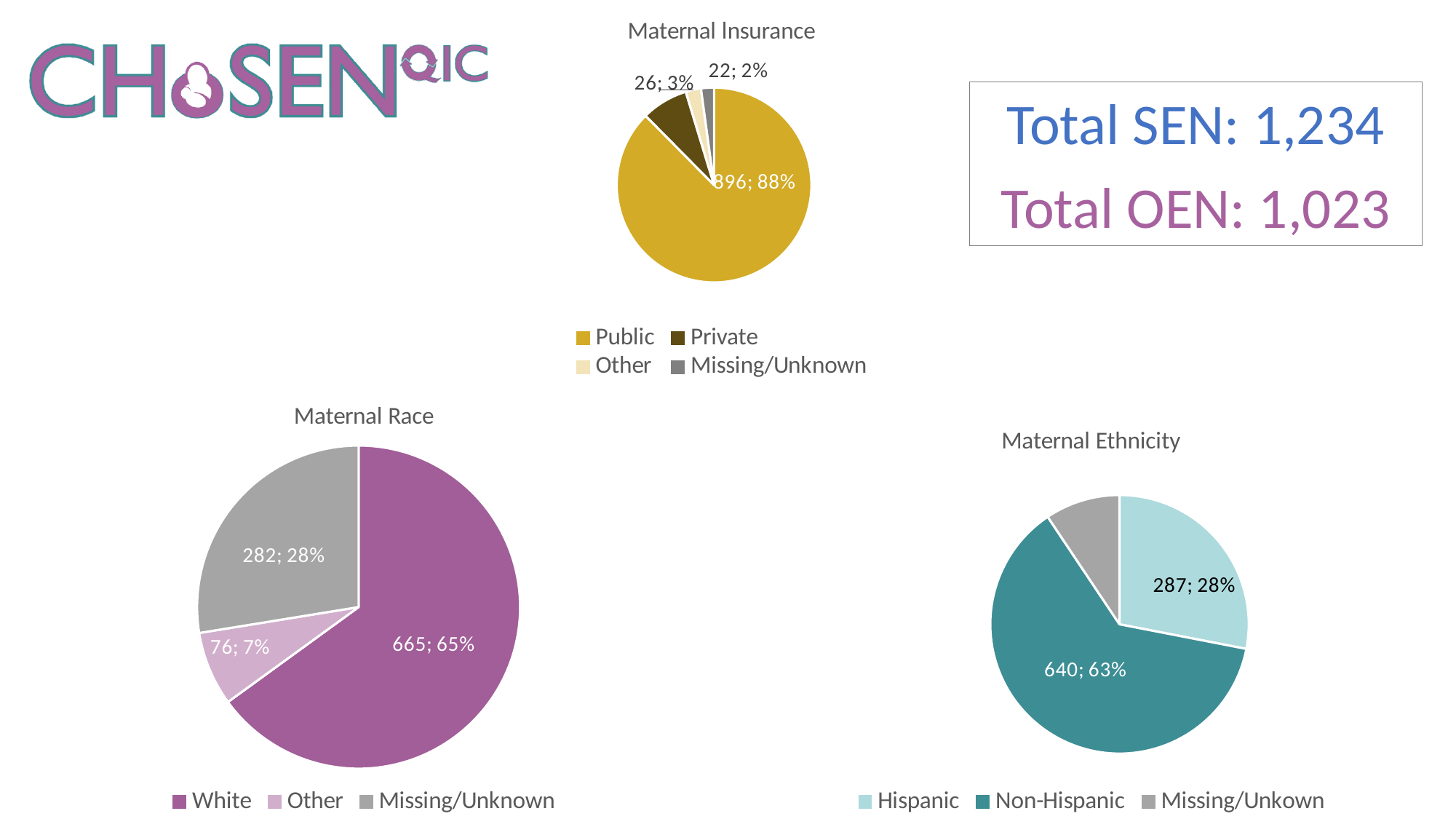
How many entries does the legend of the Maternal Insurance chart list? 4 In the Maternal Ethnicity chart, what is the value shown for Non-Hispanic? 640; 63% In the Maternal Race chart, what is the difference between the counts for White and Missing/Unknown? 383 What kind of chart is the Maternal Race chart? Pie chart In the Maternal Ethnicity chart, what share of the pie is Hispanic? 28% In the Maternal Insurance chart, what is the value shown for Public? 896; 88% In the Maternal Race chart, what is the count for Missing/Unknown? 282 In the Maternal Ethnicity chart, which is larger, Hispanic or Non-Hispanic? Non-Hispanic In the Maternal Insurance chart, which category is the largest? Public In the Maternal Race chart, what is the value shown for White? 665; 65% In the Maternal Race chart, which category is the smallest? Other